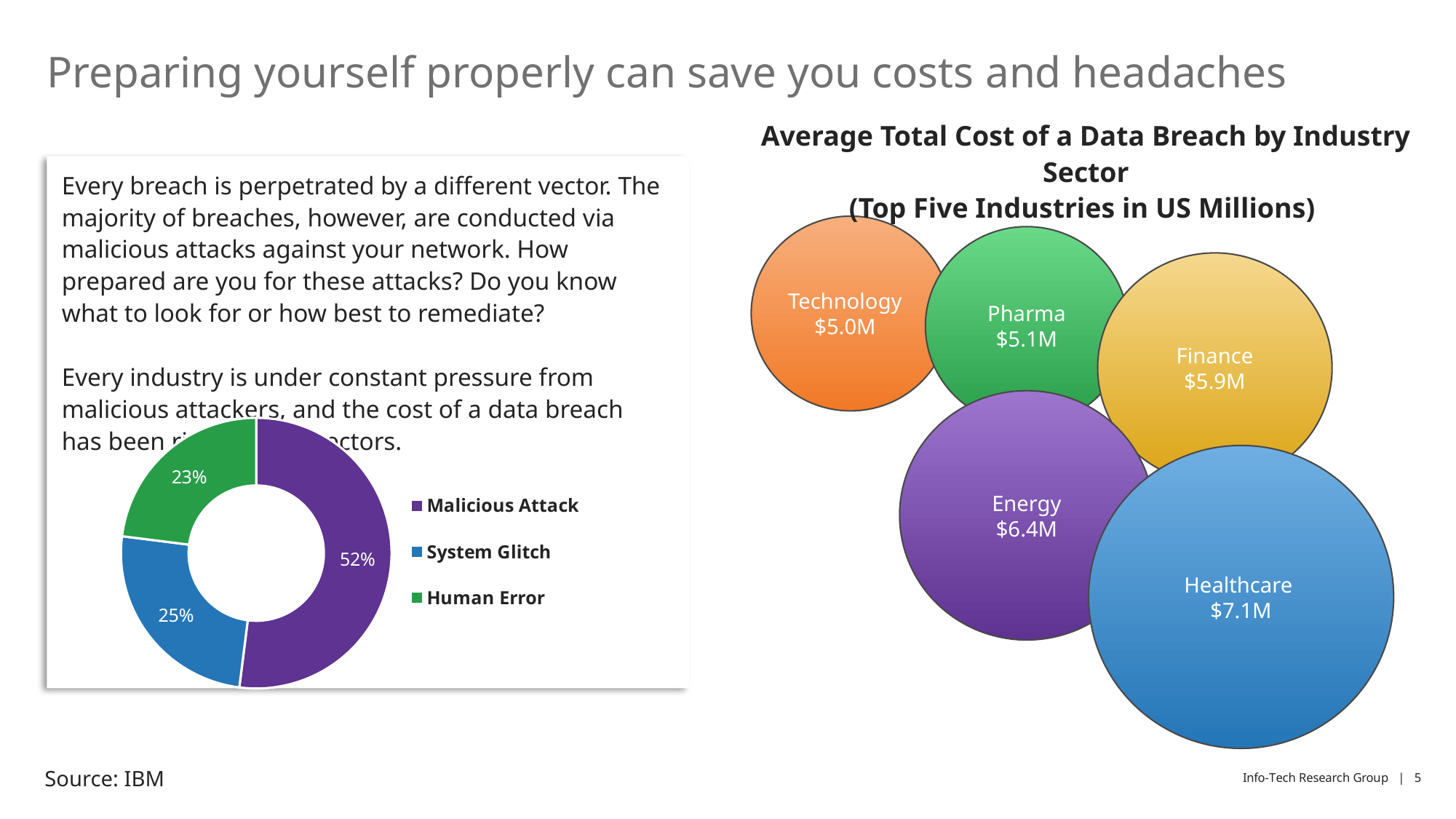
In the 'Average Total Cost of a Data Breach by Industry Sector' chart, which industry has the lowest average total cost? Technology In the doughnut chart on the left, what share of breaches is attributed to Human Error? 23% In the doughnut chart on the left, what share of breaches is attributed to Malicious Attack? 52% In the doughnut chart on the left, which breach vector has the largest share? Malicious Attack In the doughnut chart on the left, what is the difference in percentage points between Malicious Attack and System Glitch? 27 In the 'Average Total Cost of a Data Breach by Industry Sector' chart, what is the average total cost for Healthcare? $7.1M In the doughnut chart on the left, how many categories does the legend list? 3 In the doughnut chart on the left, what share of breaches is attributed to System Glitch? 25% In the 'Average Total Cost of a Data Breach by Industry Sector' chart, what is the average total cost for Finance? $5.9M In the 'Average Total Cost of a Data Breach by Industry Sector' chart, which is larger, the cost for Energy or the cost for Pharma? Energy In the 'Average Total Cost of a Data Breach by Industry Sector' chart, what is the difference between the Healthcare and Technology costs? $2.1M In the doughnut chart on the left, which breach vector has the smallest share? Human Error